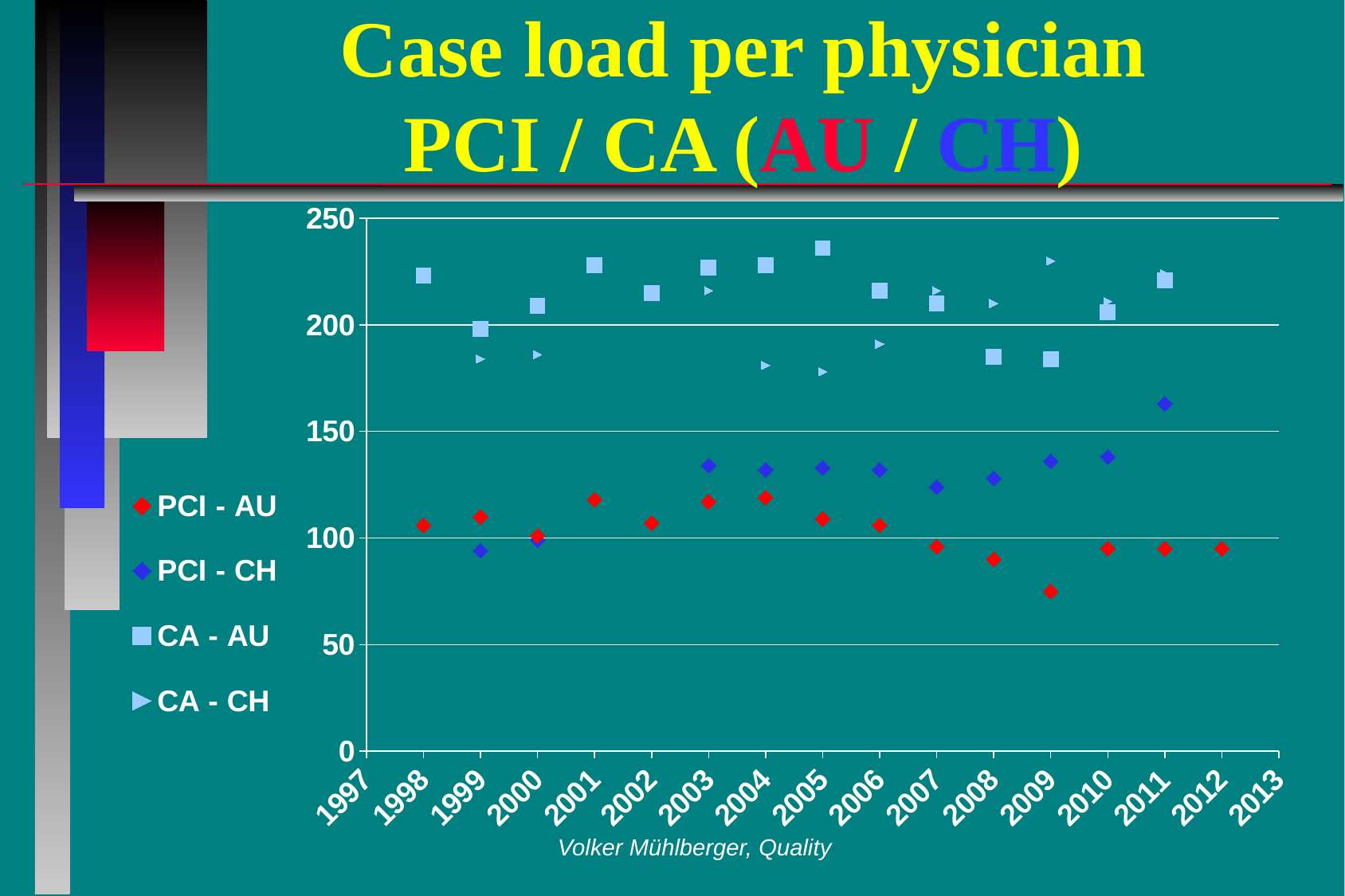
In 2005, which is larger: CA - AU or PCI - AU? CA - AU Is the value for PCI - AU in 2009 greater or less than 100? less In which year is the CA - AU value highest? 2005 What kind of chart is shown on the slide? scatter chart Is the value for PCI - CH in 2011 greater or less than 150? greater What is the title of the chart? Case load per physician PCI / CA (AU / CH) How many series does the legend list? 4 Is the value for CA - AU in 2005 greater or less than 200? greater In 2009, which is larger: PCI - CH or PCI - AU? PCI - CH In which year is the PCI - AU value lowest? 2009 Do the PCI - AU values rise or fall from 2005 to 2009? fall